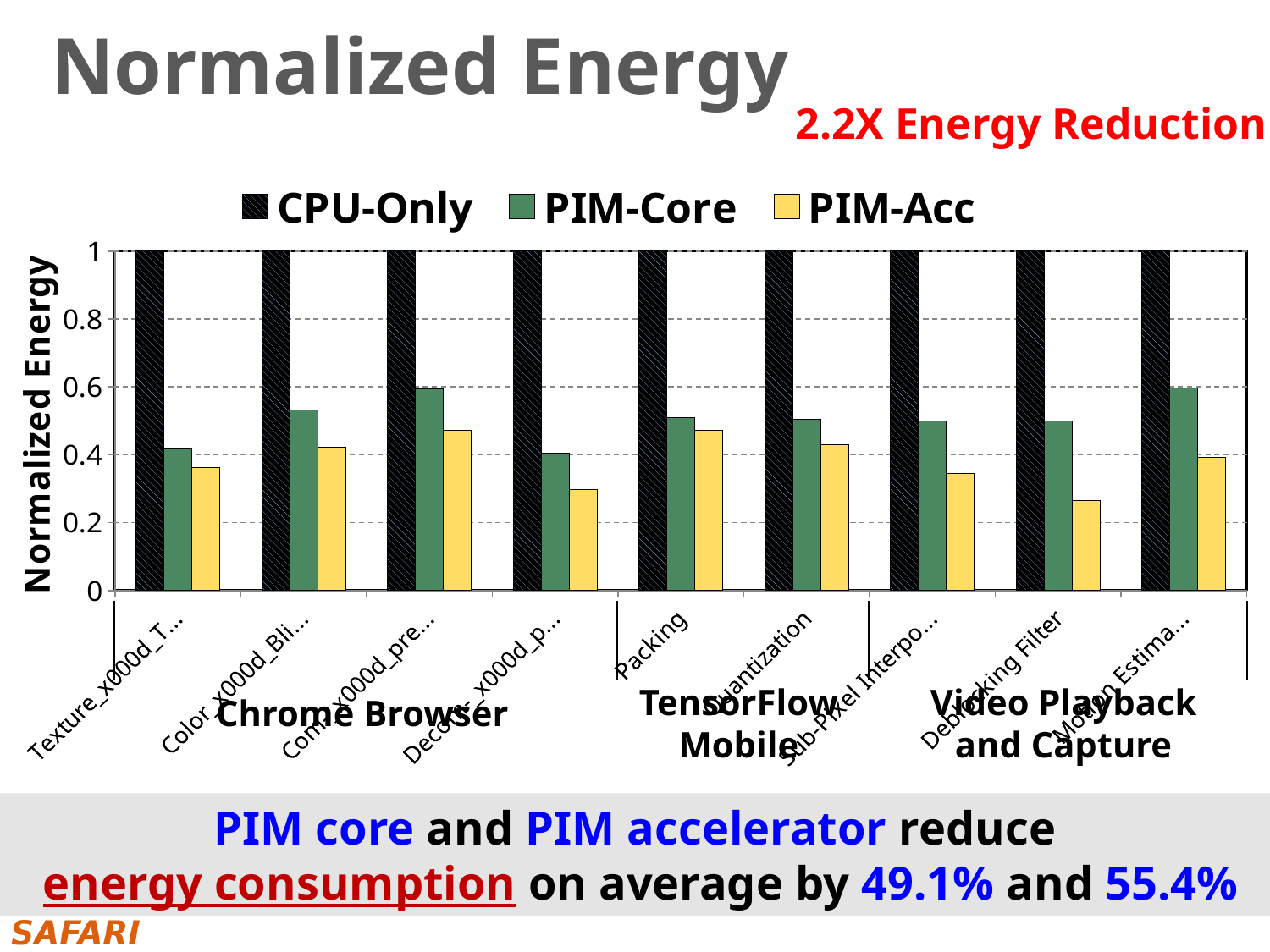
What is the label on the y axis of the chart? Normalized Energy How many categories (workloads) are plotted along the x axis? 9 What is the Normalized Energy value for CPU-Only for Deblocking Filter? 1 What kind of chart is shown on the slide? bar chart For Deblocking Filter, which is larger: the PIM-Core value or the PIM-Acc value? PIM-Core Is the PIM-Core value for Packing greater or less than 0.4? greater What is the Normalized Energy value for CPU-Only for Packing? 1 Is the PIM-Acc value for Deblocking Filter greater or less than 0.4? less What are the three series listed in the chart legend? CPU-Only, PIM-Core, PIM-Acc Is the PIM-Core value for Quantization greater or less than 0.6? less Which series has the highest value for every category in the chart? CPU-Only How many series does the chart legend list? 3